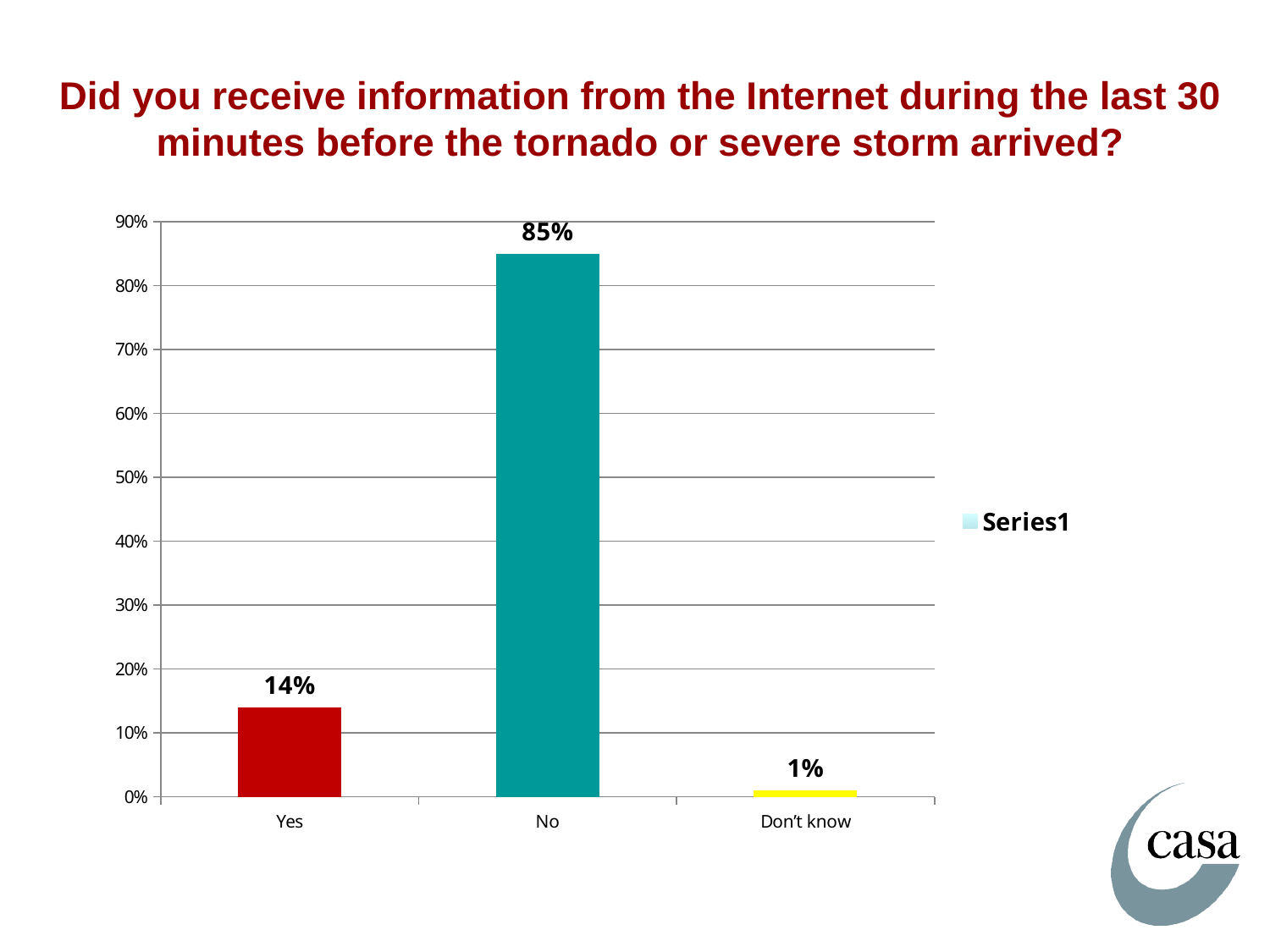
Is the value for "Yes" greater or less than 20%? less What percentage of respondents answered "Yes"? 14% Which response category has the highest value? No What is the name of the series listed in the legend? Series1 What kind of chart is shown on the slide? Bar chart What percentage of respondents answered "Don't know"? 1% What is the difference between the "No" and "Yes" percentages? 71% What percentage of respondents answered "No"? 85% Which is larger, the value for "Yes" or the value for "Don't know"? Yes Which response category has the lowest value? Don't know How many response categories are shown on the x axis? 3 Is the value for "No" greater or less than 80%? greater